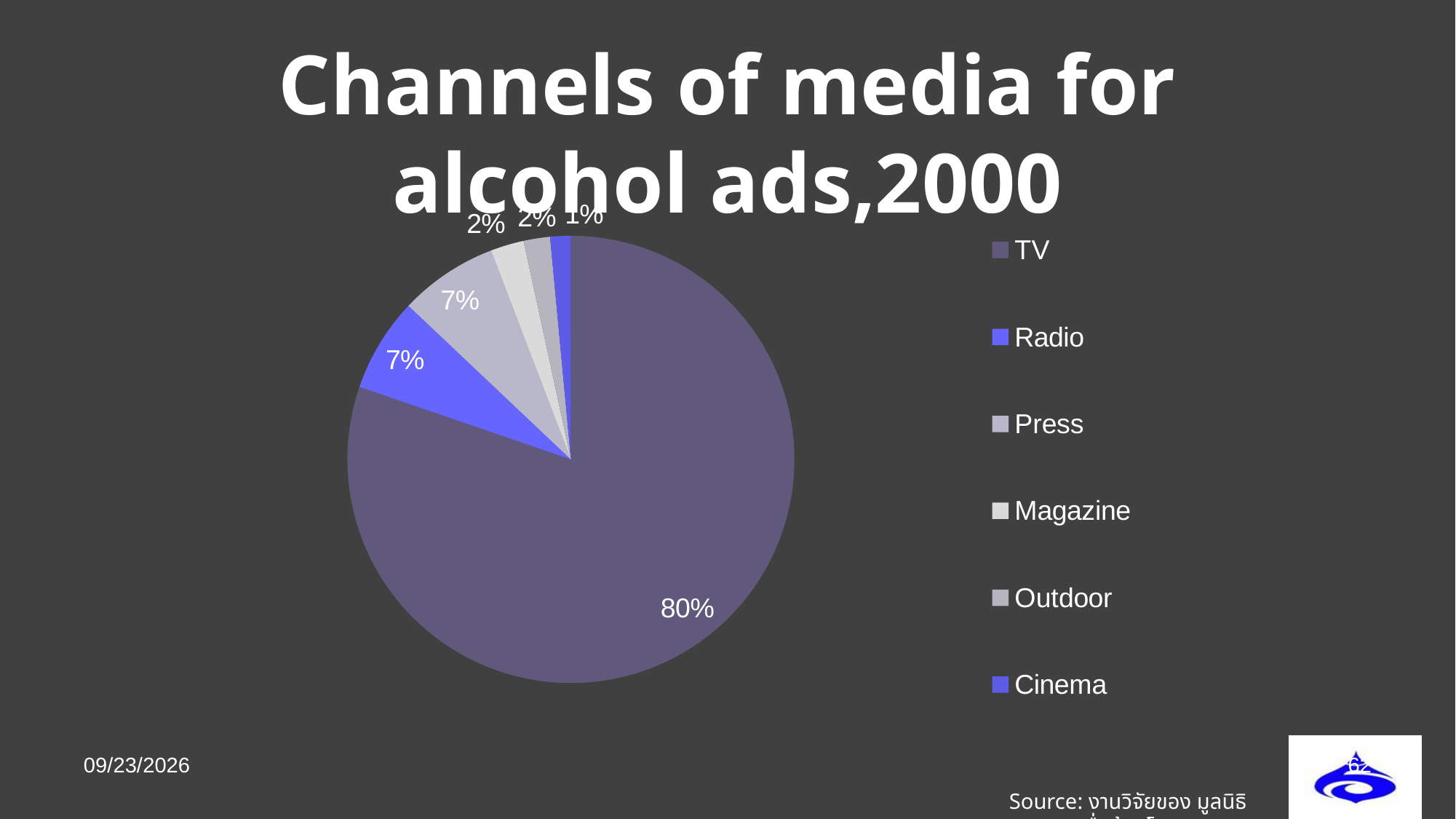
How many percentage points larger is the TV share than the Radio share? 73 percentage points What percentage is shown for Press? 7% What is the title of the chart? Channels of media for alcohol ads,2000 Which media channel has the smallest share of the pie? Cinema What share of the pie does TV account for? 80% What type of chart is shown on the slide? Pie chart Which has the larger share, TV or Press? TV What percentage is shown for Radio? 7% How many media channels are shown in the pie chart? 6 What percentage is shown for Magazine? 2% Which media channel has the largest share of the pie? TV What percentage is shown for Cinema? 1%